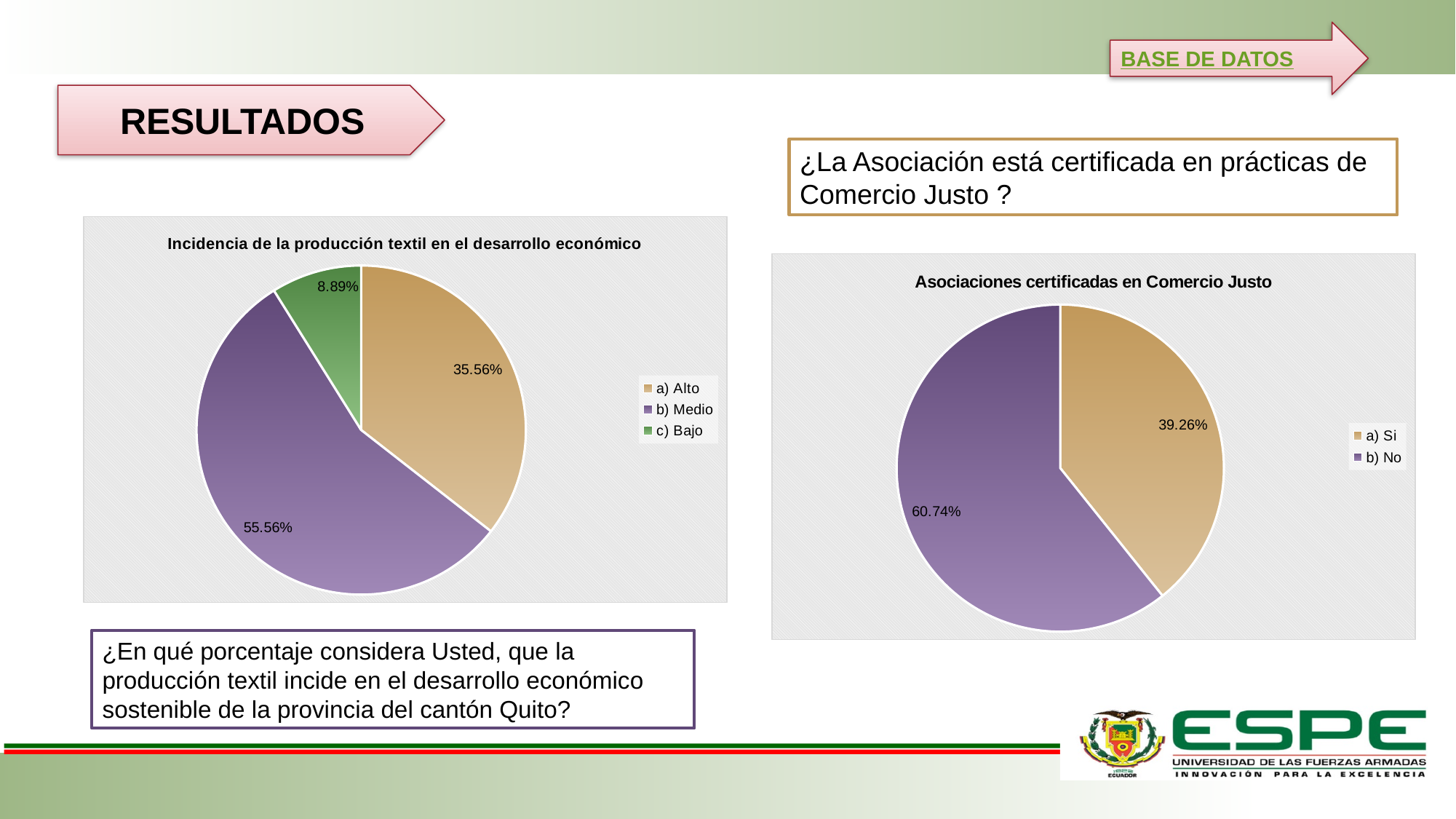
In the chart titled 'Incidencia de la producción textil en el desarrollo económico', what is the difference in percentage points between 'b) Medio' and 'a) Alto'? 20 percentage points In the chart titled 'Incidencia de la producción textil en el desarrollo económico', what percentage is shown for 'a) Alto'? 35.56% In the chart titled 'Incidencia de la producción textil en el desarrollo económico', how many categories does the legend list? 3 What type of chart is 'Asociaciones certificadas en Comercio Justo'? Pie chart In the chart titled 'Asociaciones certificadas en Comercio Justo', what colour is the slice for 'b) No'? Purple In the chart titled 'Asociaciones certificadas en Comercio Justo', what percentage is shown for 'b) No'? 60.74% In the chart titled 'Asociaciones certificadas en Comercio Justo', what is the difference in percentage points between 'b) No' and 'a) Si'? 21.48 percentage points In the chart titled 'Incidencia de la producción textil en el desarrollo económico', which category has the largest slice? b) Medio In the chart titled 'Incidencia de la producción textil en el desarrollo económico', what percentage is shown for 'b) Medio'? 55.56% In the chart titled 'Incidencia de la producción textil en el desarrollo económico', which category has the smallest slice? c) Bajo In the chart titled 'Asociaciones certificadas en Comercio Justo', which is larger, 'a) Si' or 'b) No'? b) No In the chart titled 'Asociaciones certificadas en Comercio Justo', what percentage is shown for 'a) Si'? 39.26%